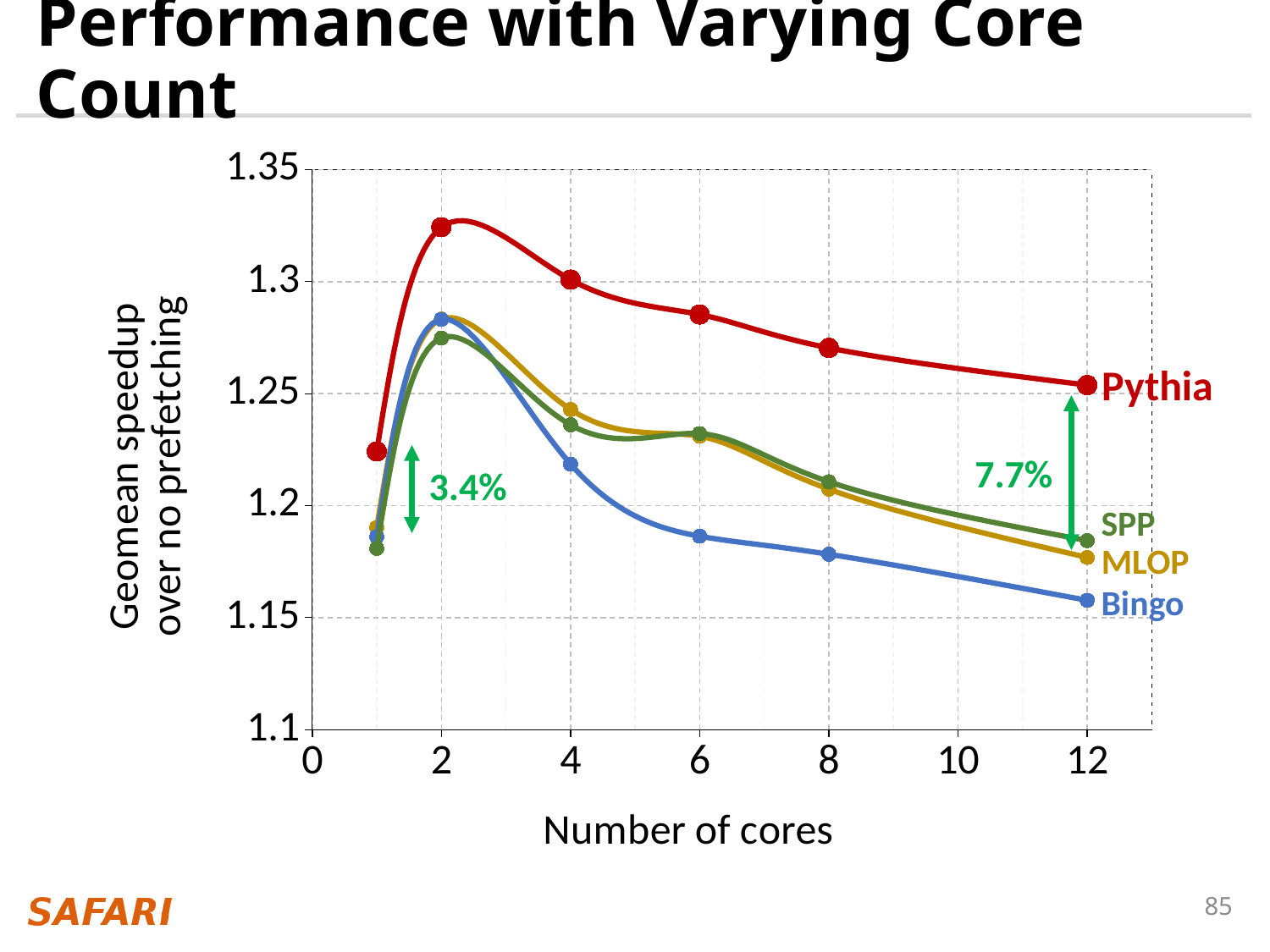
Which series has the lowest geomean speedup at 12 cores? Bingo How many core-count data points are plotted for the Pythia series? 6 Does the geomean speedup for Pythia rise or fall as the number of cores increases from 2 to 12? fall What percentage gap is annotated near 1 core on the chart? 3.4% At 4 cores, which series has the larger geomean speedup, Pythia or Bingo? Pythia Which series has the highest geomean speedup at 12 cores? Pythia Is the geomean speedup for Pythia at 2 cores greater or less than 1.3? greater How many series (prefetchers) are plotted on the chart? 4 Is the geomean speedup for Bingo at 12 cores greater or less than 1.2? less What percentage gap is annotated between Pythia and SPP at 12 cores? 7.7% Is the geomean speedup for SPP at 8 cores greater or less than 1.25? less What kind of chart is shown on the slide? line chart